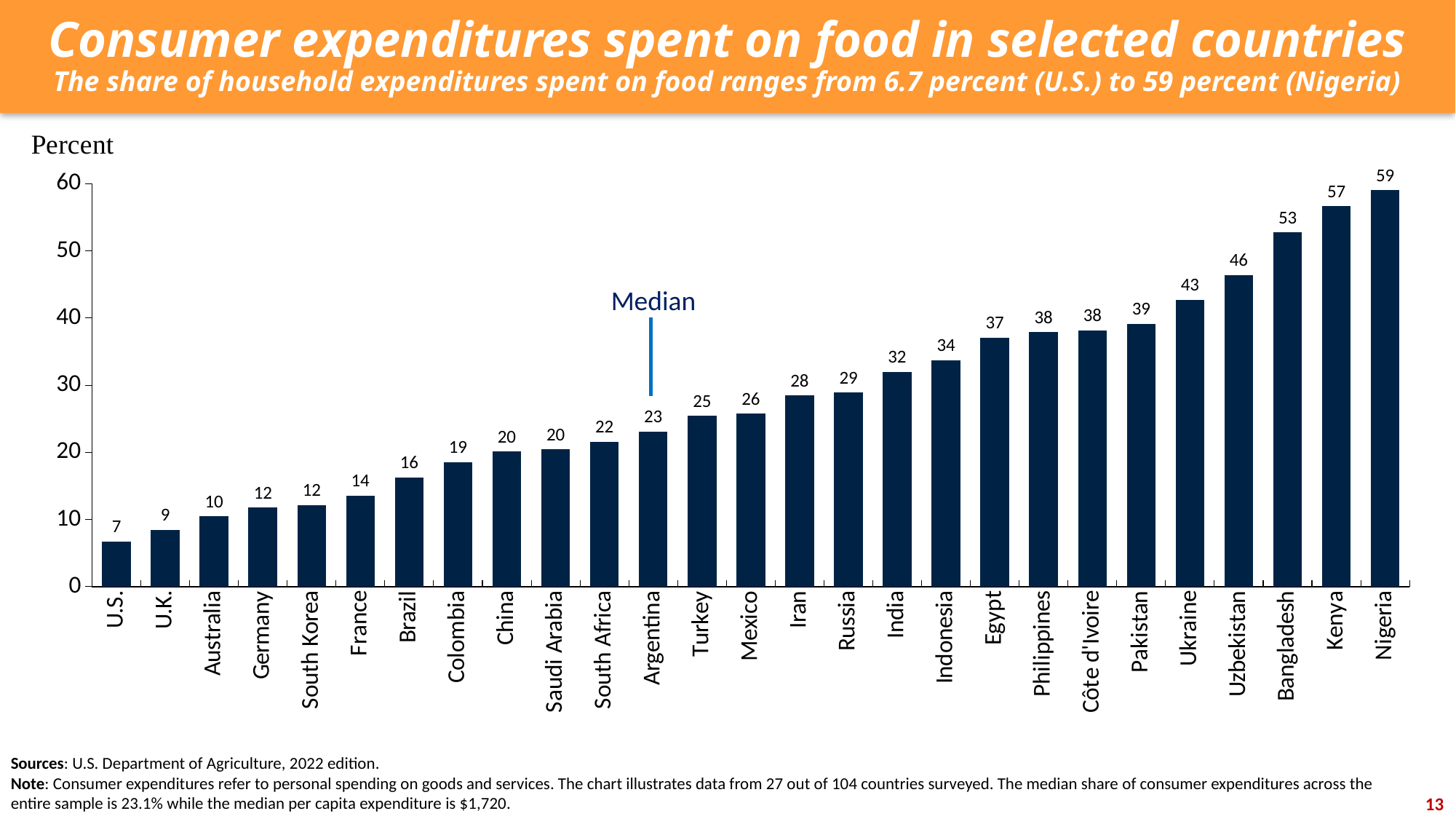
Which country is marked as the median in the chart? Argentina Do the values rise or fall from left to right along the x axis? rise What is the value for Indonesia? 34 Is the value for Uzbekistan greater or less than 40? greater What is the difference between the values for Kenya and Bangladesh? 4 Which country has the lowest value? U.S. What is the value for Ukraine? 43 Which country has the highest value? Nigeria What is the value for Brazil? 16 How many countries are shown in the chart? 27 Which has a larger value, Mexico or Turkey? Mexico What kind of chart is shown on the slide? bar chart